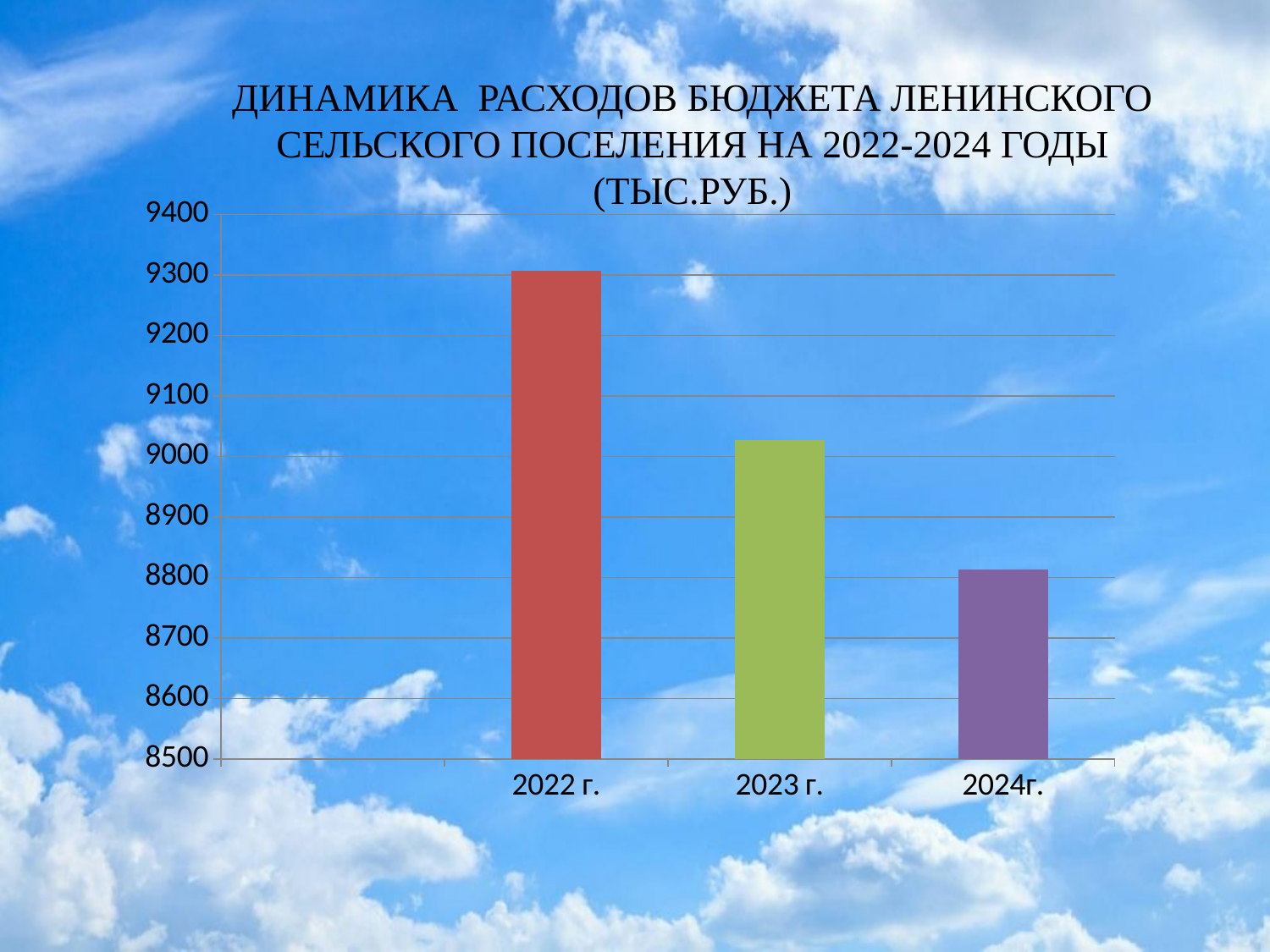
Which year has the highest budget expenditure in the chart? 2022 г. Is the value for 2023 г. greater or less than 9100? less Which is larger, the value for 2022 г. or the value for 2023 г.? 2022 г. What kind of chart is shown on the slide? bar chart Is the value for 2022 г. greater or less than 9200? greater Do the values rise or fall from 2022 г. to 2024г.? fall How many bars (years) are plotted in the chart? 3 Is the value for 2024г. greater or less than 8700? greater In what units are the values in the chart expressed, according to the title? ТЫС.РУБ. What is the lowest value shown on the vertical axis? 8500 Which year has the lowest budget expenditure in the chart? 2024г. Which is larger, the value for 2023 г. or the value for 2024г.? 2023 г.